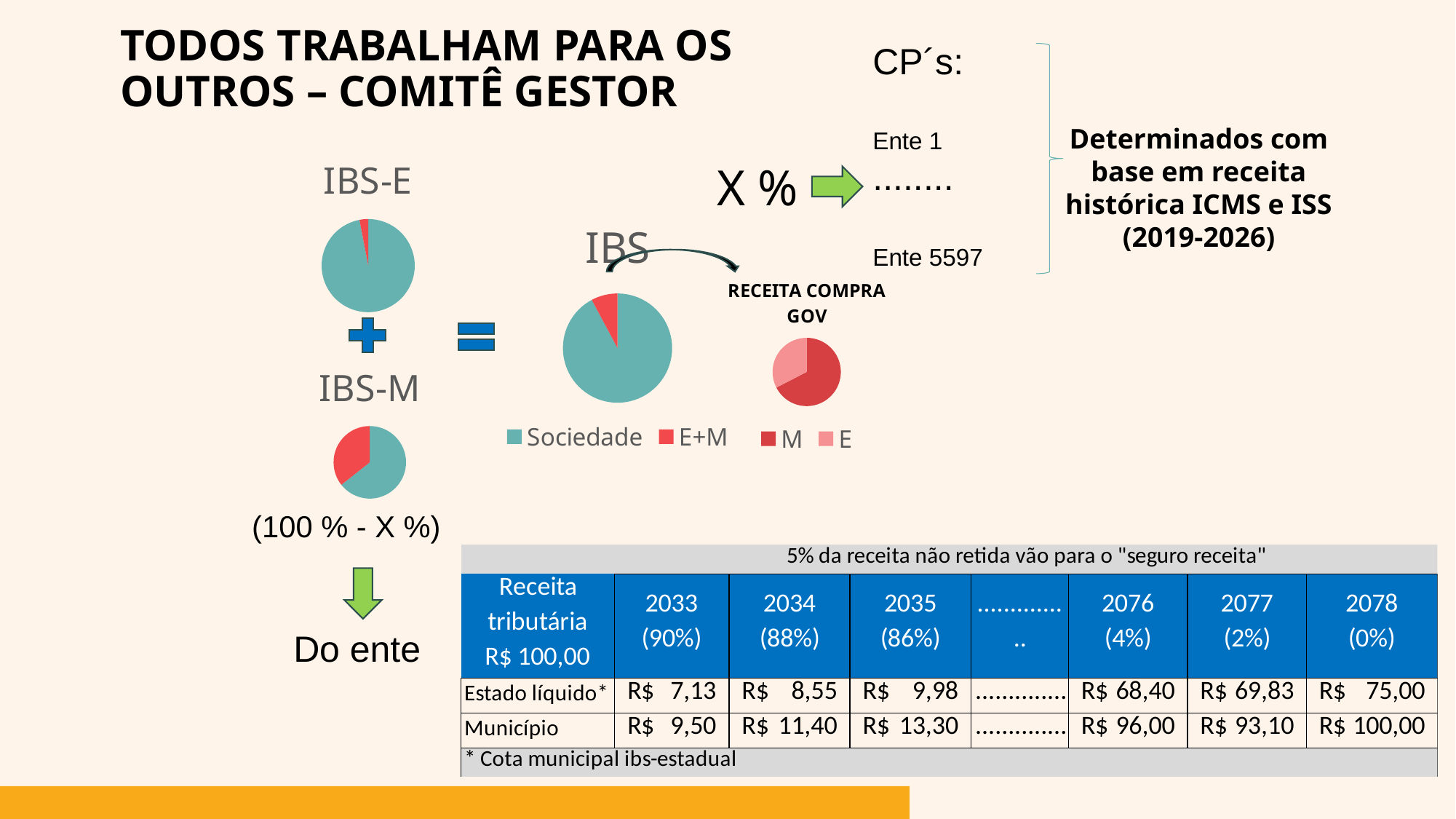
In the IBS pie chart, which slice is larger, Sociedade or E+M? Sociedade What colour represents Sociedade in the legend below the IBS pie chart? teal How many entries does the legend below the IBS pie chart list? 2 What is the title of the pie chart whose legend lists M and E? RECEITA COMPRA GOV What kind of chart is the IBS-E chart? pie chart How many slices does the IBS-E pie chart have? 2 In the RECEITA COMPRA GOV pie chart, which slice is larger, M or E? M How many pie charts are shown on the slide? 4 How many entries does the legend below the RECEITA COMPRA GOV pie chart list? 2